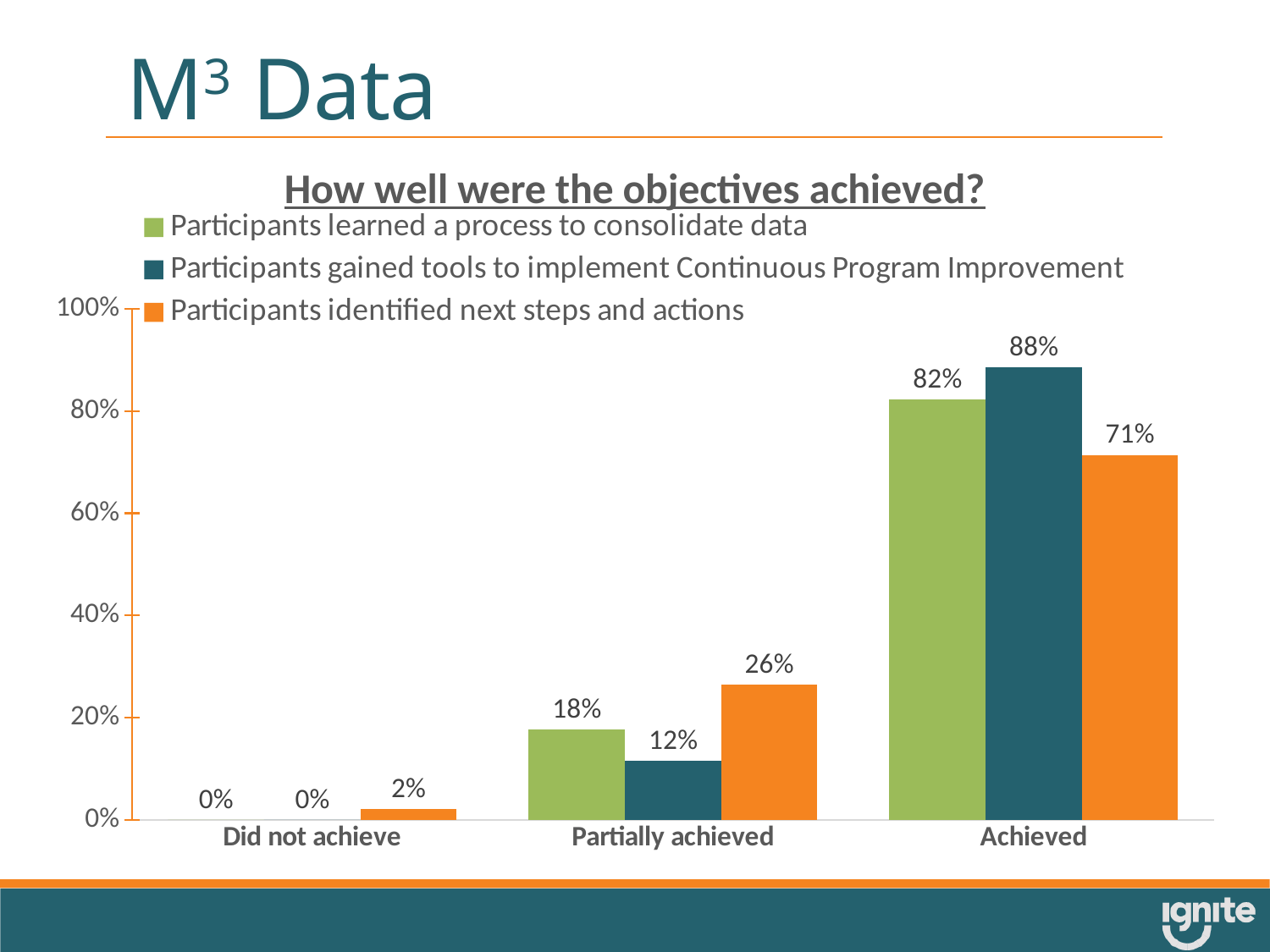
What is the title of the chart? How well were the objectives achieved? What is the difference between the 'Achieved' values for 'Participants learned a process to consolidate data' and 'Participants identified next steps and actions'? 11% What is the value for 'Did not achieve' in the series 'Participants identified next steps and actions'? 2% How many categories are shown on the x axis? 3 Is the 'Achieved' value for 'Participants identified next steps and actions' greater or less than 80%? less How many series does the legend list? 3 What kind of chart is shown on the slide? bar chart In the 'Partially achieved' category, which is larger: 'Participants learned a process to consolidate data' or 'Participants gained tools to implement Continuous Program Improvement'? Participants learned a process to consolidate data Which series has the highest value in the 'Achieved' category? Participants gained tools to implement Continuous Program Improvement What percentage of participants 'Achieved' the objective 'Participants gained tools to implement Continuous Program Improvement'? 88% Which series has the lowest value in the 'Achieved' category? Participants identified next steps and actions What is the value for 'Partially achieved' in the series 'Participants identified next steps and actions'? 26%